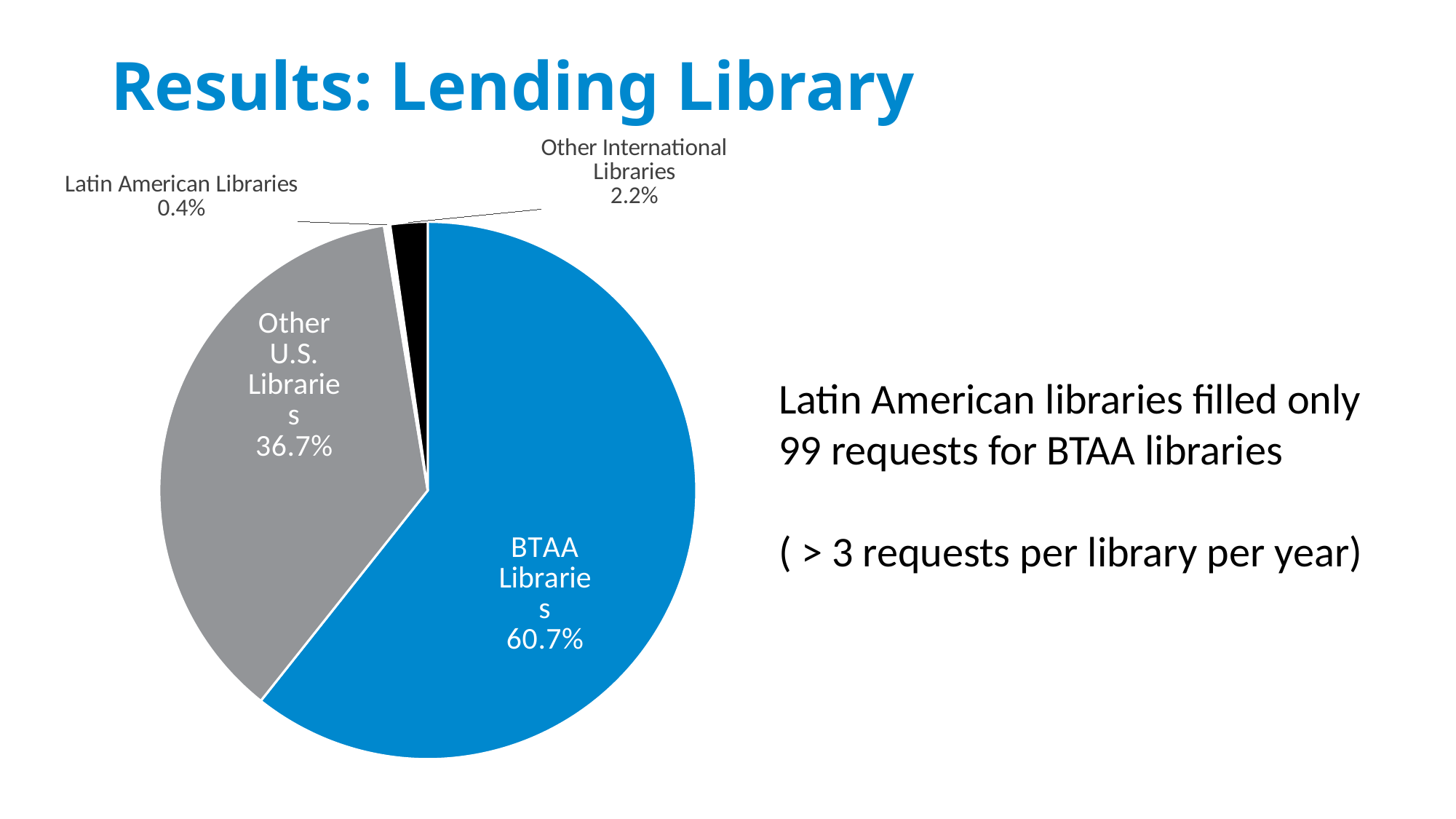
Which category has the smallest slice of the pie? Latin American Libraries What share of the pie do Other U.S. Libraries account for? 36.7% What share of the pie do Other International Libraries account for? 2.2% How many slices does the pie chart have? 4 What is the difference in percentage points between BTAA Libraries and Other U.S. Libraries? 24 percentage points What share of the pie do Latin American Libraries account for? 0.4% What kind of chart is shown on the slide? pie chart What is the combined share of Other International Libraries and Latin American Libraries? 2.6% What colour is the BTAA Libraries slice? blue Which is larger, the share for Other International Libraries or the share for Latin American Libraries? Other International Libraries Which category has the largest slice of the pie? BTAA Libraries